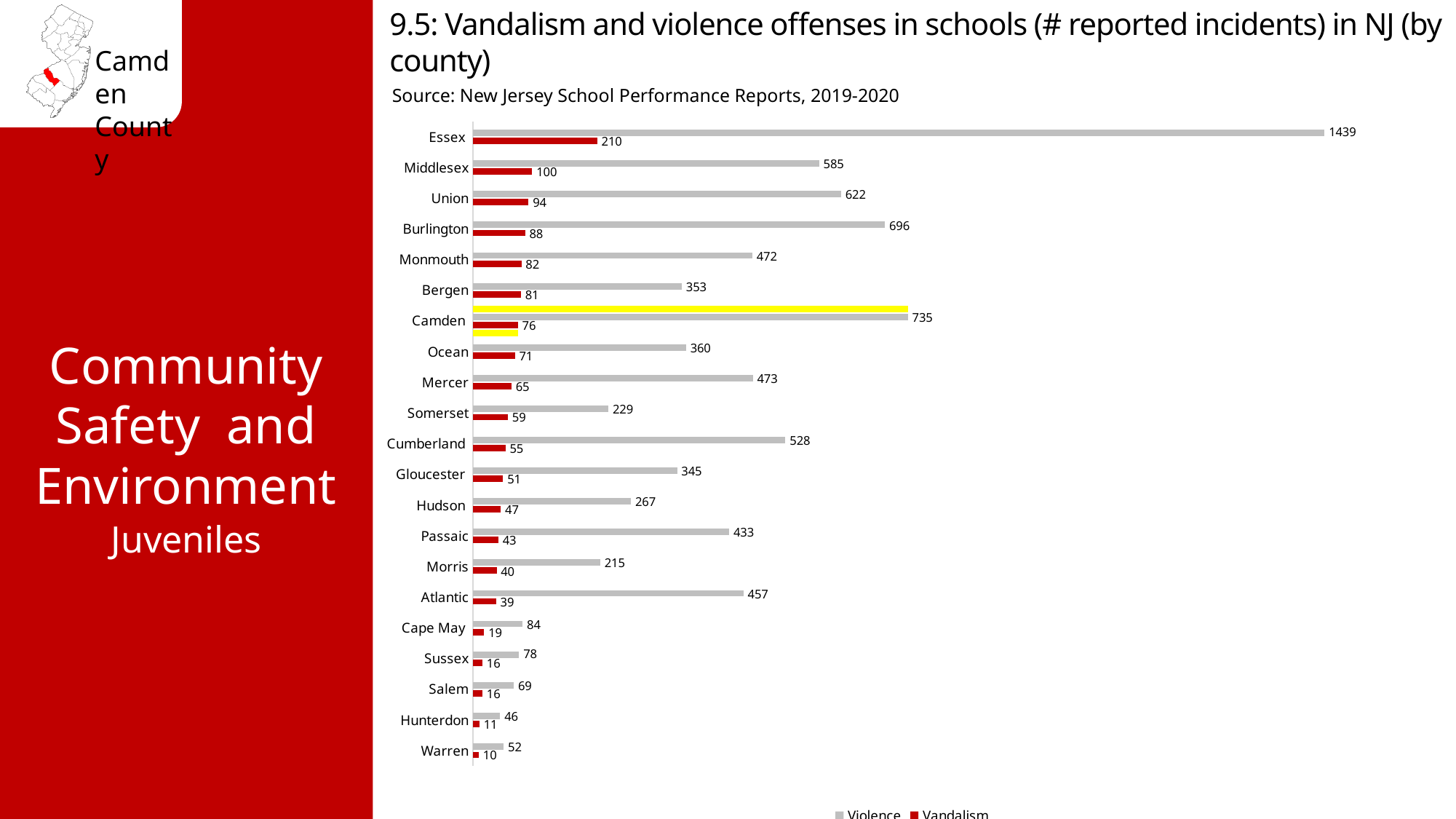
What is the difference between the vandalism incidents in Middlesex and Union? 6 Which county has more reported vandalism incidents, Ocean or Mercer? Ocean How many counties are shown on the chart? 21 What is the number of reported violence incidents for Camden County? 735 How many series does the legend list? 2 What type of chart is shown on the slide? Bar chart How many reported violence incidents does Cumberland County have? 528 What is the number of reported vandalism incidents for Essex County? 210 What is the difference between the violence incidents in Essex and Camden? 704 Which county has the highest number of reported violence incidents? Essex Which county has more reported violence incidents, Burlington or Union? Burlington Which county has the lowest number of reported vandalism incidents? Warren